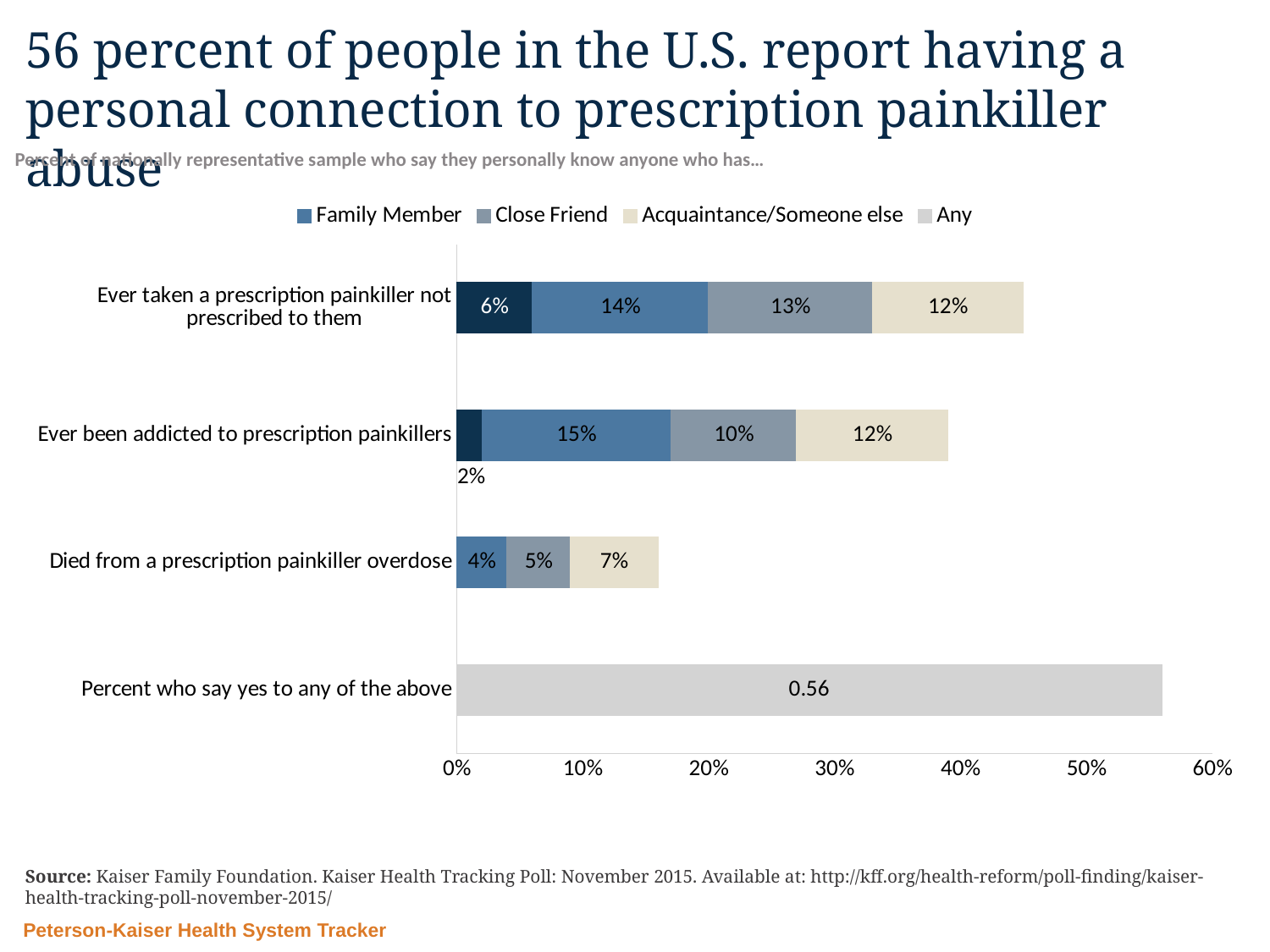
What value is shown for 'Percent who say yes to any of the above'? 0.56 What percentage of respondents say an acquaintance/someone else has ever taken a prescription painkiller not prescribed to them? 12% For 'Died from a prescription painkiller overdose', which is larger: the Close Friend value or the Acquaintance/Someone else value? Acquaintance/Someone else How many categories are shown on the vertical axis of the chart? 4 How much larger is the Close Friend value for 'Ever taken a prescription painkiller not prescribed to them' than for 'Ever been addicted to prescription painkillers'? 3% Which category has the longest bar overall? Percent who say yes to any of the above How many series does the legend list? 4 What is the total of the stacked bar for 'Ever taken a prescription painkiller not prescribed to them'? 45% What type of chart is shown on the slide? Bar chart What is the Close Friend value for 'Ever been addicted to prescription painkillers'? 10% What is the total of the stacked bar for 'Died from a prescription painkiller overdose'? 16% What is the Acquaintance/Someone else value for 'Died from a prescription painkiller overdose'? 7%